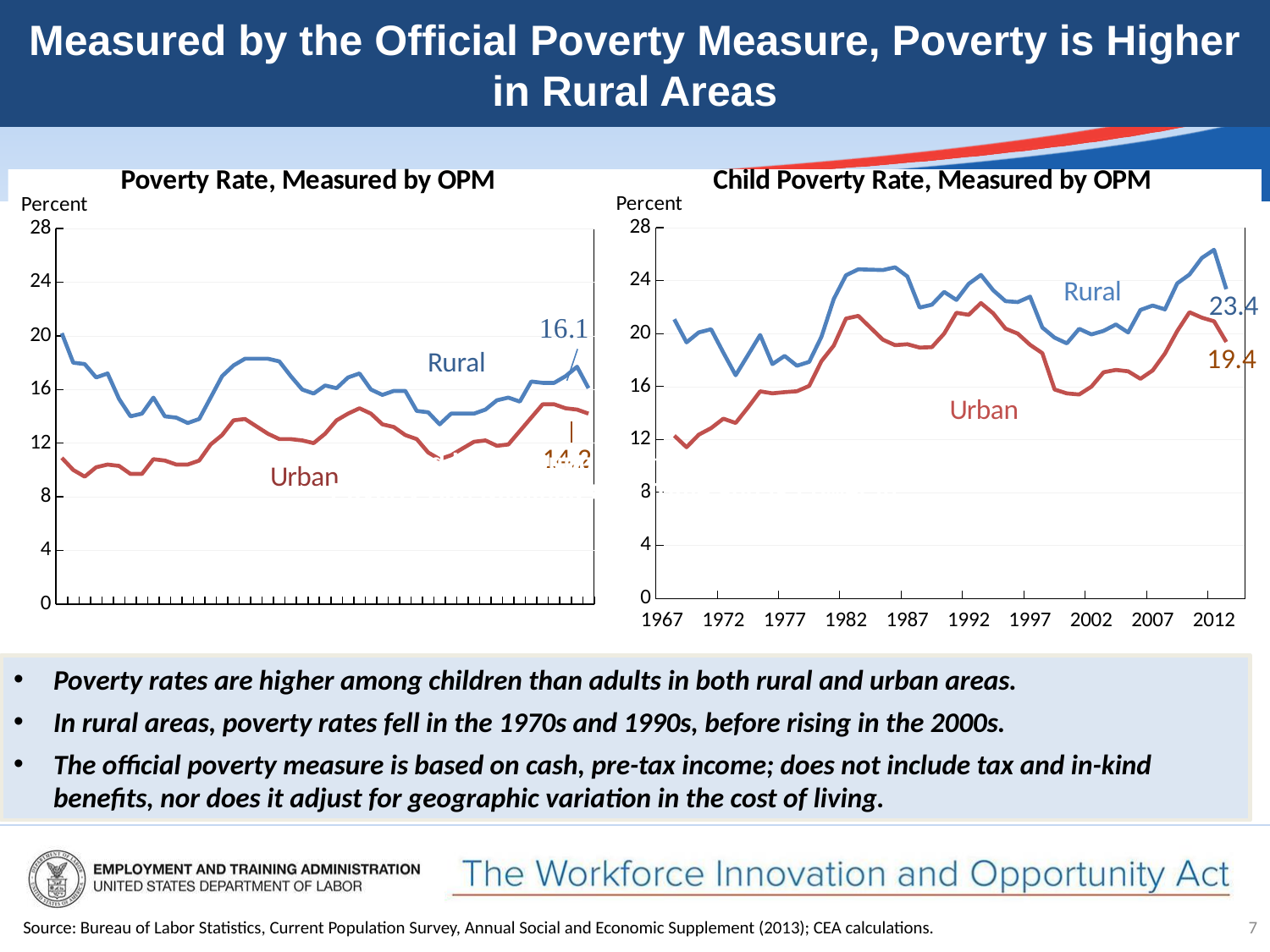
What unit is shown on the y axis of the 'Poverty Rate, Measured by OPM' chart? Percent How many series are plotted in the 'Child Poverty Rate, Measured by OPM' chart? 2 In the 'Child Poverty Rate, Measured by OPM' chart, is the Urban value in 1967 greater or less than 16? less In the 'Child Poverty Rate, Measured by OPM' chart, which line is higher at the end of the series, Rural or Urban? Rural In the 'Poverty Rate, Measured by OPM' chart, what is the labelled final value of the Urban line? 14.2 In the 'Child Poverty Rate, Measured by OPM' chart, what is the first year shown on the x axis? 1967 In the 'Child Poverty Rate, Measured by OPM' chart, what is the labelled final value of the Rural line? 23.4 In the 'Poverty Rate, Measured by OPM' chart, what is the difference between the final Rural value and the final Urban value? 1.9 In the 'Child Poverty Rate, Measured by OPM' chart, what is the difference between the final Rural value and the final Urban value? 4.0 In the 'Child Poverty Rate, Measured by OPM' chart, what is the labelled final value of the Urban line? 19.4 What kind of chart is the 'Poverty Rate, Measured by OPM' chart on the left? line chart In the 'Poverty Rate, Measured by OPM' chart, what is the labelled final value of the Rural line? 16.1